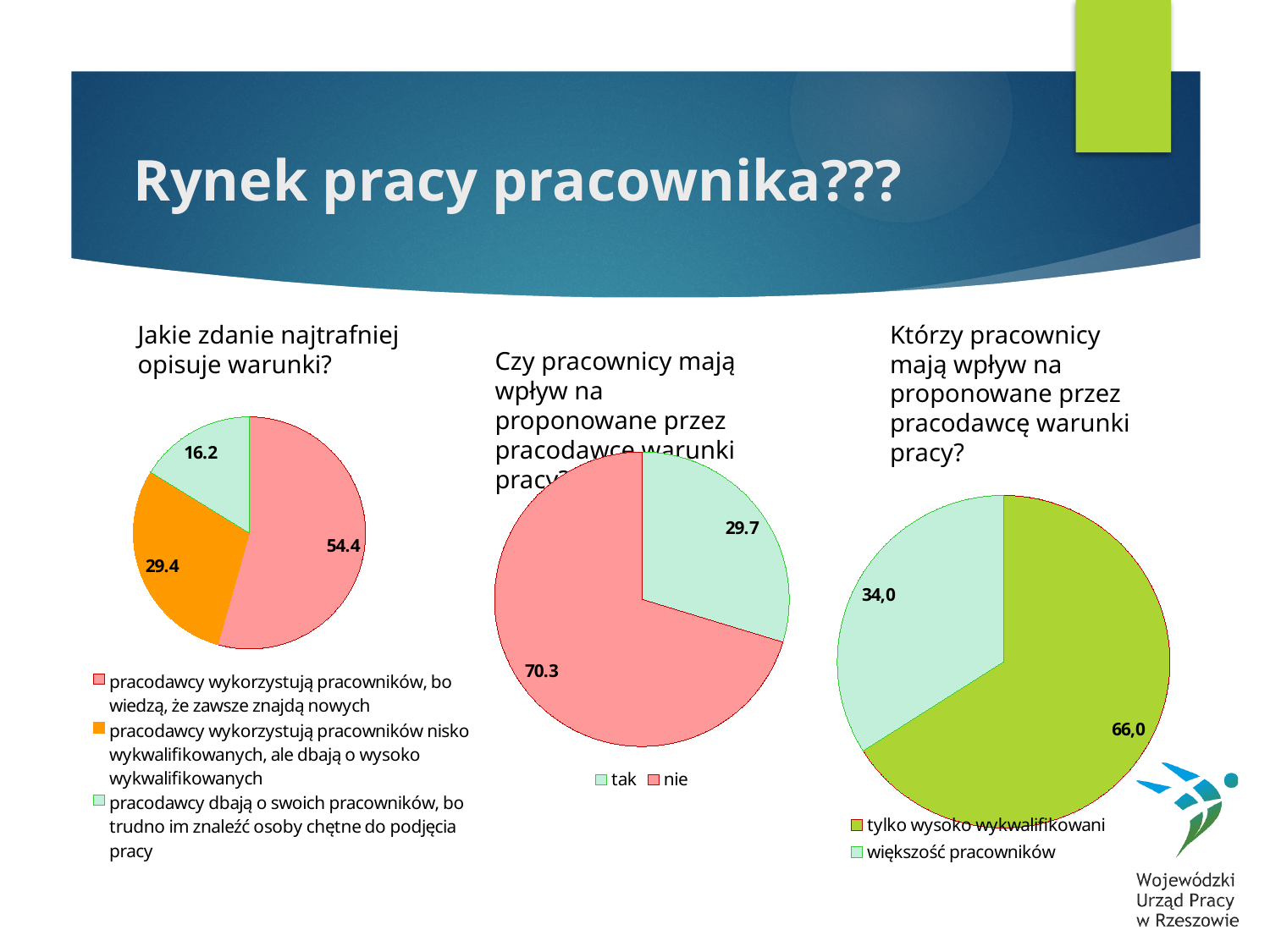
How many slices does the left pie chart have? 3 In the right pie chart, what is the value for "większość pracowników"? 34,0 What type of chart is used for all three charts on the slide? pie chart In the left pie chart, what is the value for "pracodawcy dbają o swoich pracowników, bo trudno im znaleźć osoby chętne do podjęcia pracy"? 16.2 In the left pie chart, what is the difference between the largest slice (54.4) and the orange slice (29.4)? 25.0 In the middle pie chart ("Czy pracownicy mają wpływ na proponowane przez pracodawcę warunki pracy?"), what is the value for "nie"? 70.3 In the middle pie chart, what is the value for "tak"? 29.7 In the right pie chart ("Którzy pracownicy mają wpływ na proponowane przez pracodawcę warunki pracy?"), what is the value for "tylko wysoko wykwalifikowani"? 66,0 In the middle pie chart, which is larger, "tak" or "nie"? nie In the left pie chart, which category has the smallest slice? pracodawcy dbają o swoich pracowników, bo trudno im znaleźć osoby chętne do podjęcia pracy In the right pie chart, what is the difference between "tylko wysoko wykwalifikowani" and "większość pracowników"? 32,0 In the left pie chart ("Jakie zdanie najtrafniej opisuje warunki?"), what is the value for "pracodawcy wykorzystują pracowników, bo wiedzą, że zawsze znajdą nowych"? 54.4